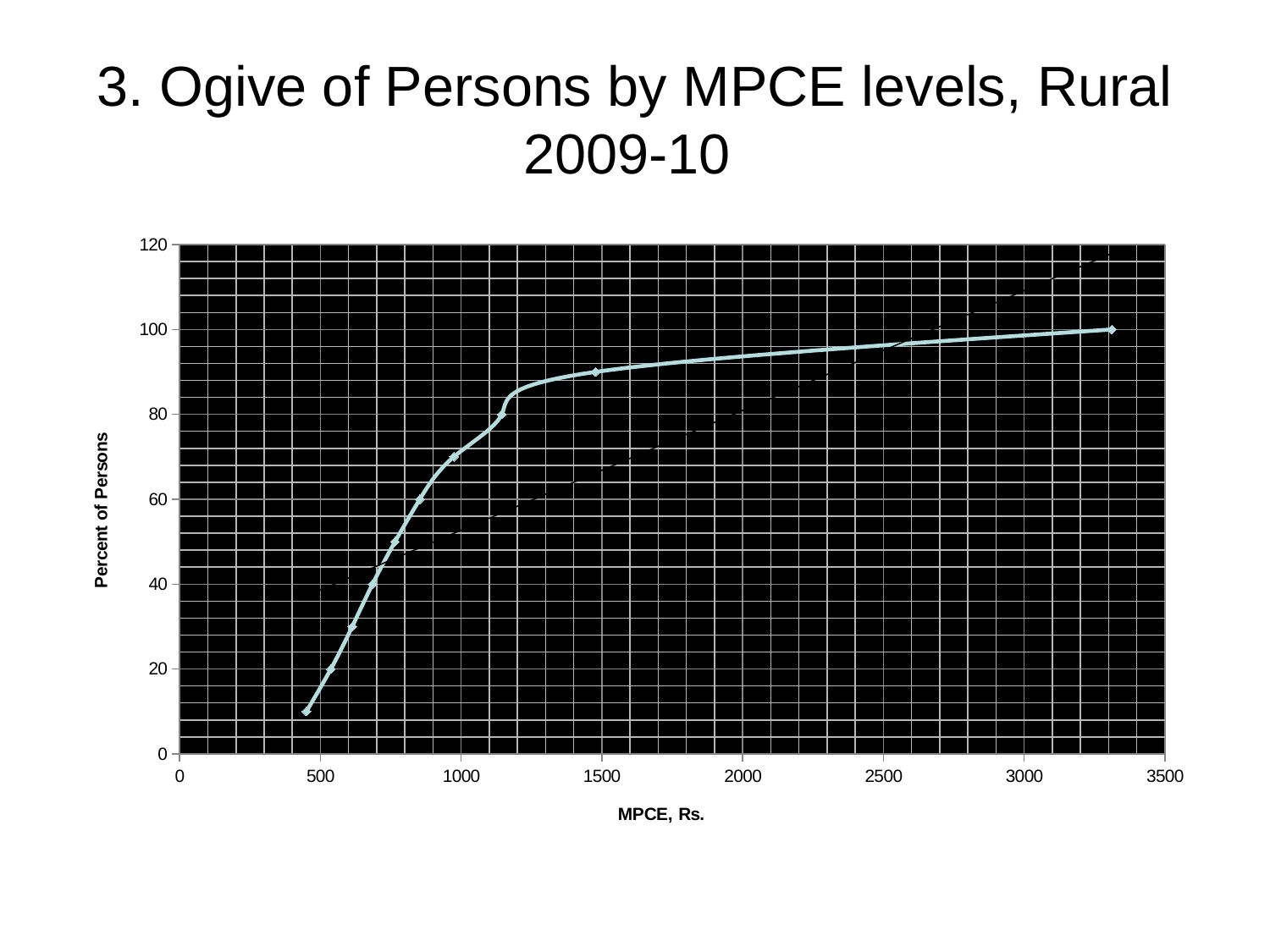
Is the percent of persons at an MPCE of 1000 Rs. greater or less than 60? greater What percent of persons does the curve reach at its highest MPCE point? 100 What is the label of the x axis? MPCE, Rs. Is the percent of persons at an MPCE of 500 Rs. greater or less than 20? less Is the percent of persons at an MPCE of 1500 Rs. greater or less than 80? greater What is the title of the chart? 3. Ogive of Persons by MPCE levels, Rural 2009-10 What kind of chart is shown on the slide? line chart Does the percent of persons rise or fall as MPCE increases along the x axis? rise